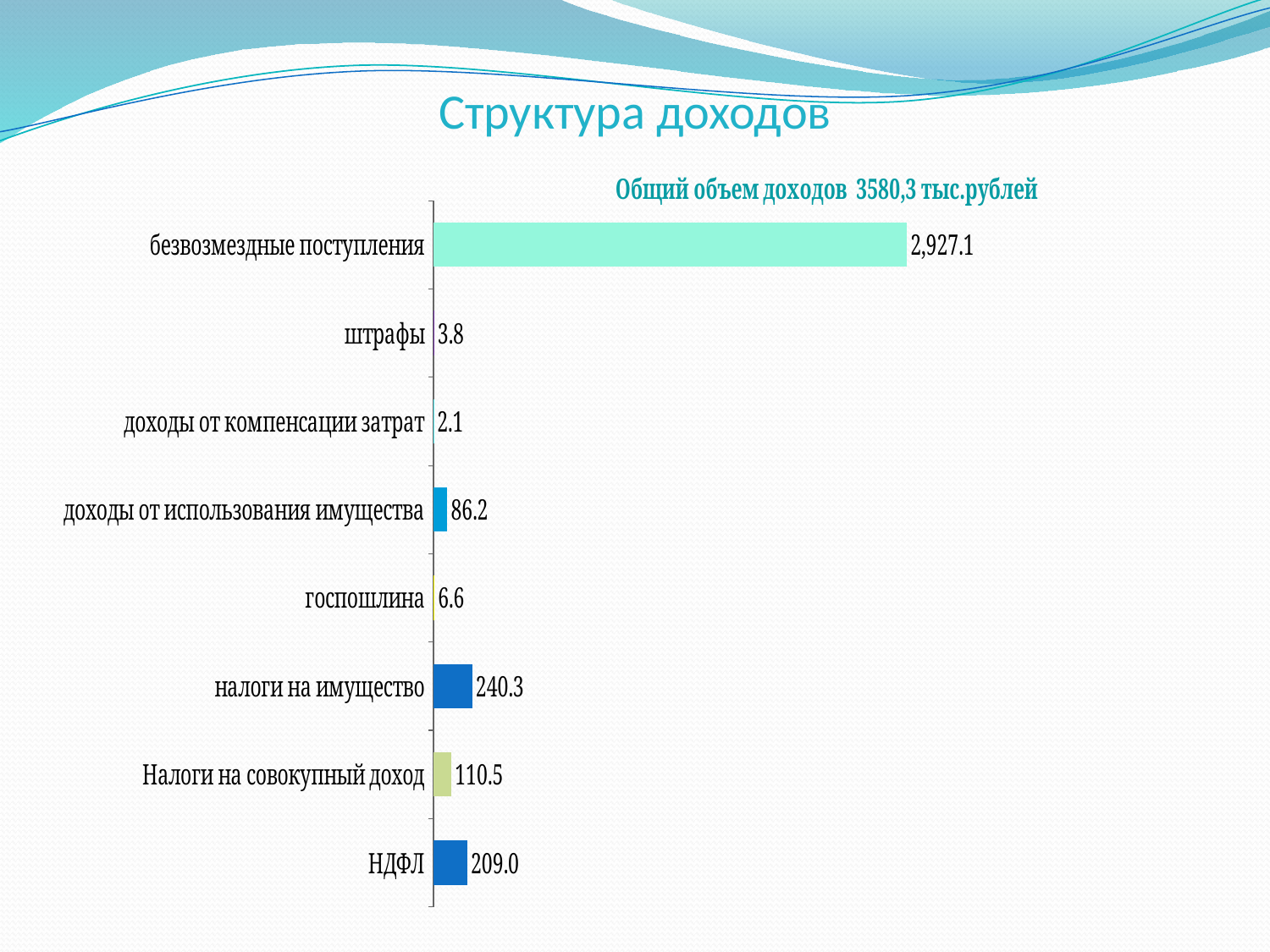
What is the value for налоги на имущество? 240.3 What is the value for безвозмездные поступления? 2,927.1 How many categories are shown in the chart? 8 What is the difference between налоги на имущество and НДФЛ? 31.3 What is the difference between штрафы and госпошлина? 2.8 Which is larger, Налоги на совокупный доход or доходы от использования имущества? Налоги на совокупный доход Which category has the highest value? безвозмездные поступления What is the value for НДФЛ? 209.0 What kind of chart is shown on the slide? bar chart What total income volume is stated above the chart? 3580,3 тыс.рублей Which category has the lowest value? доходы от компенсации затрат What is the value for доходы от использования имущества? 86.2